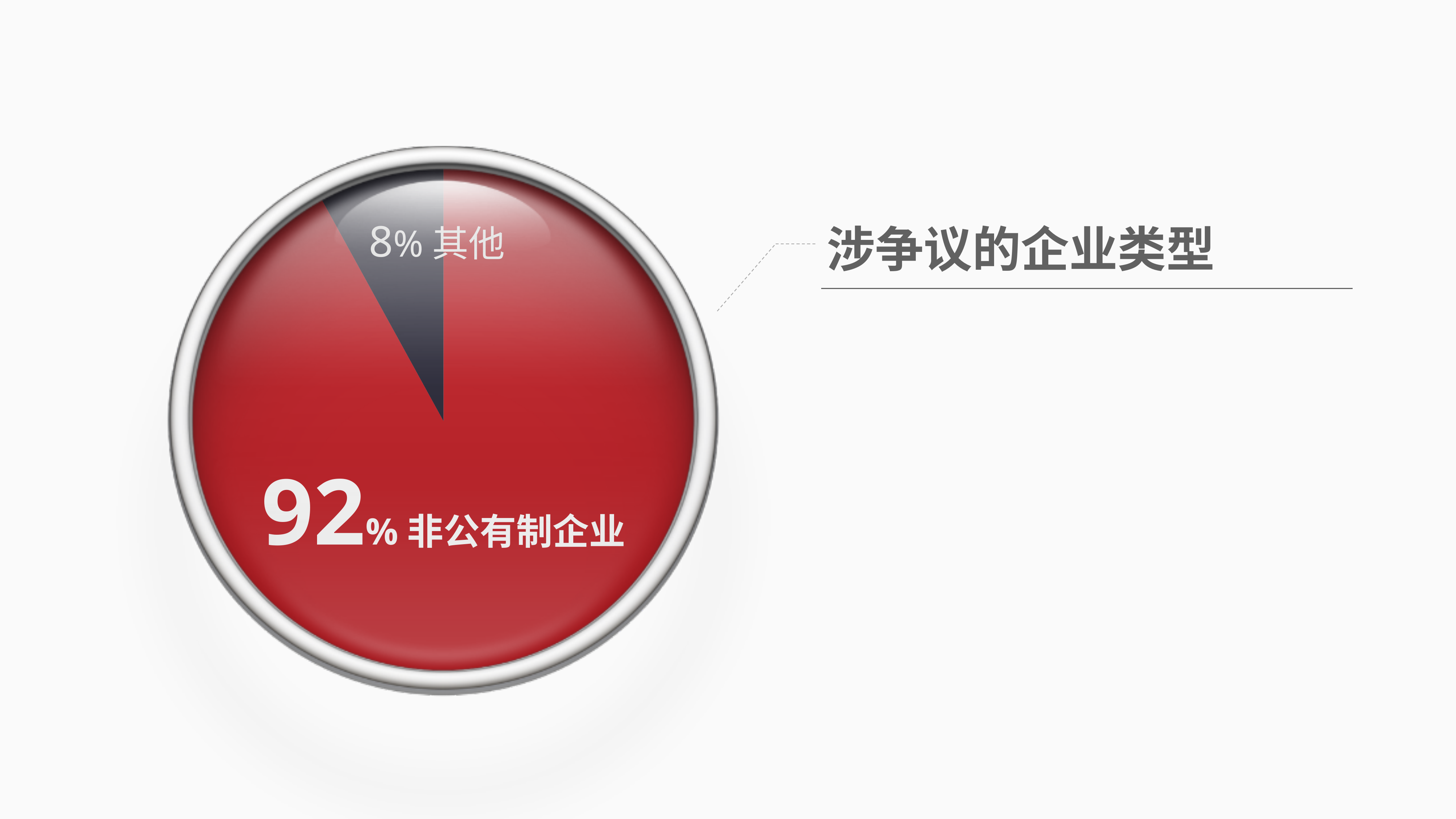
What colour is the 其他 slice of the pie chart? dark grey What is the difference in percentage points between the 非公有制企业 slice and the 其他 slice? 84 What kind of chart is shown on the slide? pie chart What share of the pie chart is labelled 其他? 8% How many slices does the pie chart have? 2 What is the total of the two slices shown in the pie chart? 100% Which slice of the pie chart is the smallest? 其他 What is the title of the chart on the slide? 涉争议的企业类型 Which slice of the pie chart is the largest? 非公有制企业 Which slice is larger, 非公有制企业 or 其他? 非公有制企业 What share of the pie chart is labelled 非公有制企业? 92%